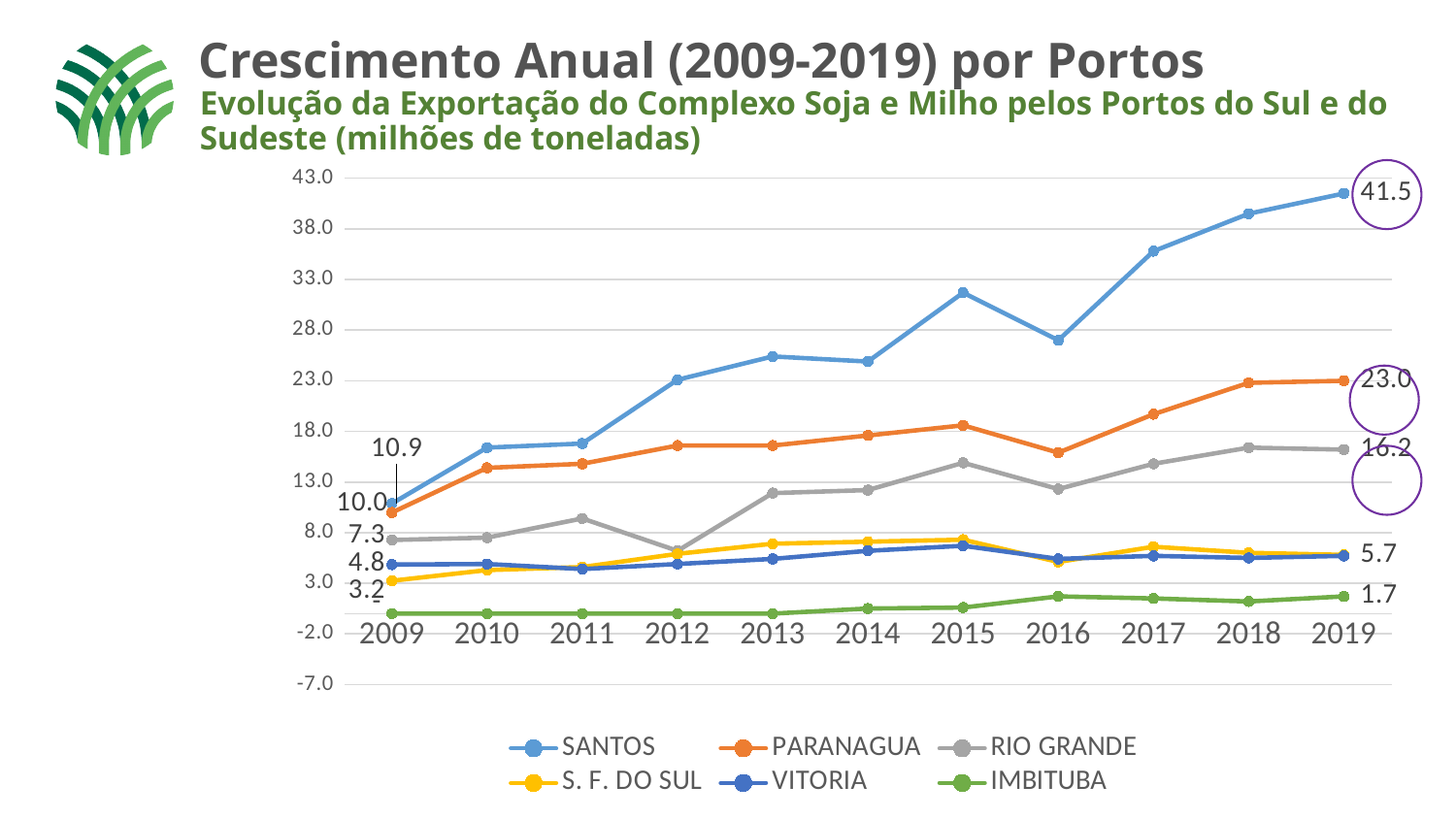
Which port has the highest value in 2019? SANTOS Which port has the lowest value in 2019? IMBITUBA How many series does the legend list? 6 What is the value for PARANAGUA in 2019? 23.0 What is the value for SANTOS in 2009? 10.9 What is the value for SANTOS in 2019? 41.5 What is the value for RIO GRANDE in 2019? 16.2 How many years are plotted along the x axis? 11 What kind of chart is shown on the slide? line chart Is the value for SANTOS in 2015 greater or less than 28.0? greater By how much did the value for SANTOS increase from 2009 to 2019? 30.6 What is the value for IMBITUBA in 2019? 1.7